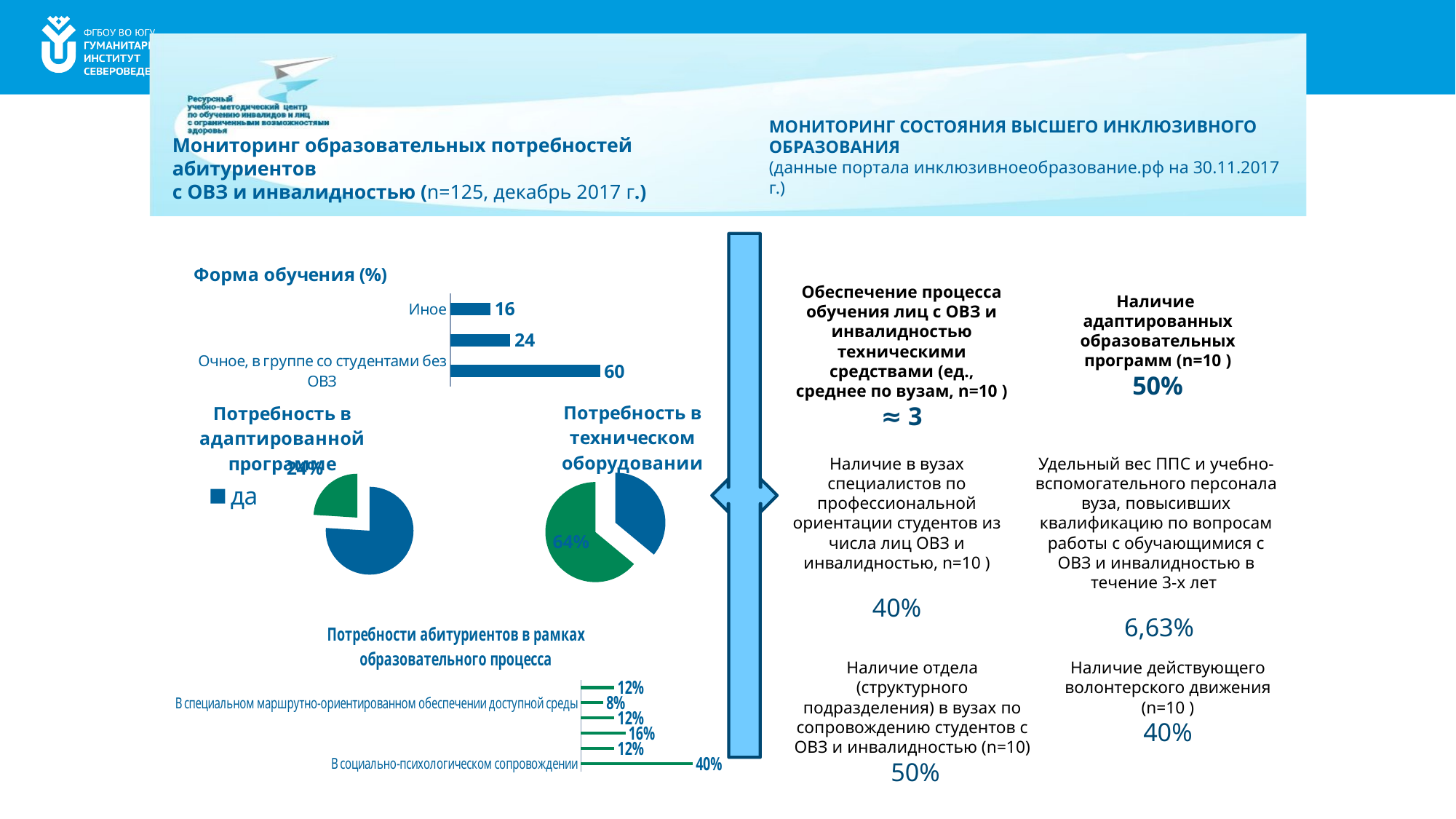
In the chart 'Потребности абитуриентов в рамках образовательного процесса', how many bars are plotted? 6 In the chart 'Форма обучения (%)', how many bars are plotted? 3 In the chart 'Потребности абитуриентов в рамках образовательного процесса', what is the value for 'В специальном маршрутно-ориентированном обеспечении доступной среды'? 8% In the chart 'Форма обучения (%)', what is the difference between the values for 'Очное, в группе со студентами без ОВЗ' and 'Иное'? 44 In the pie chart 'Потребность в техническом оборудовании', what percentage is printed on the green slice? 64% In the chart 'Форма обучения (%)', which labelled category has the lowest value? Иное In the chart 'Форма обучения (%)', which category has the highest value? Очное, в группе со студентами без ОВЗ In the chart 'Форма обучения (%)', what is the value for 'Очное, в группе со студентами без ОВЗ'? 60 In the chart 'Потребности абитуриентов в рамках образовательного процесса', which category has the highest value? В социально-психологическом сопровождении What kind of chart is 'Форма обучения (%)'? bar chart In the chart 'Форма обучения (%)', what is the value for 'Иное'? 16 In the chart 'Потребности абитуриентов в рамках образовательного процесса', what is the value for 'В социально-психологическом сопровождении'? 40%